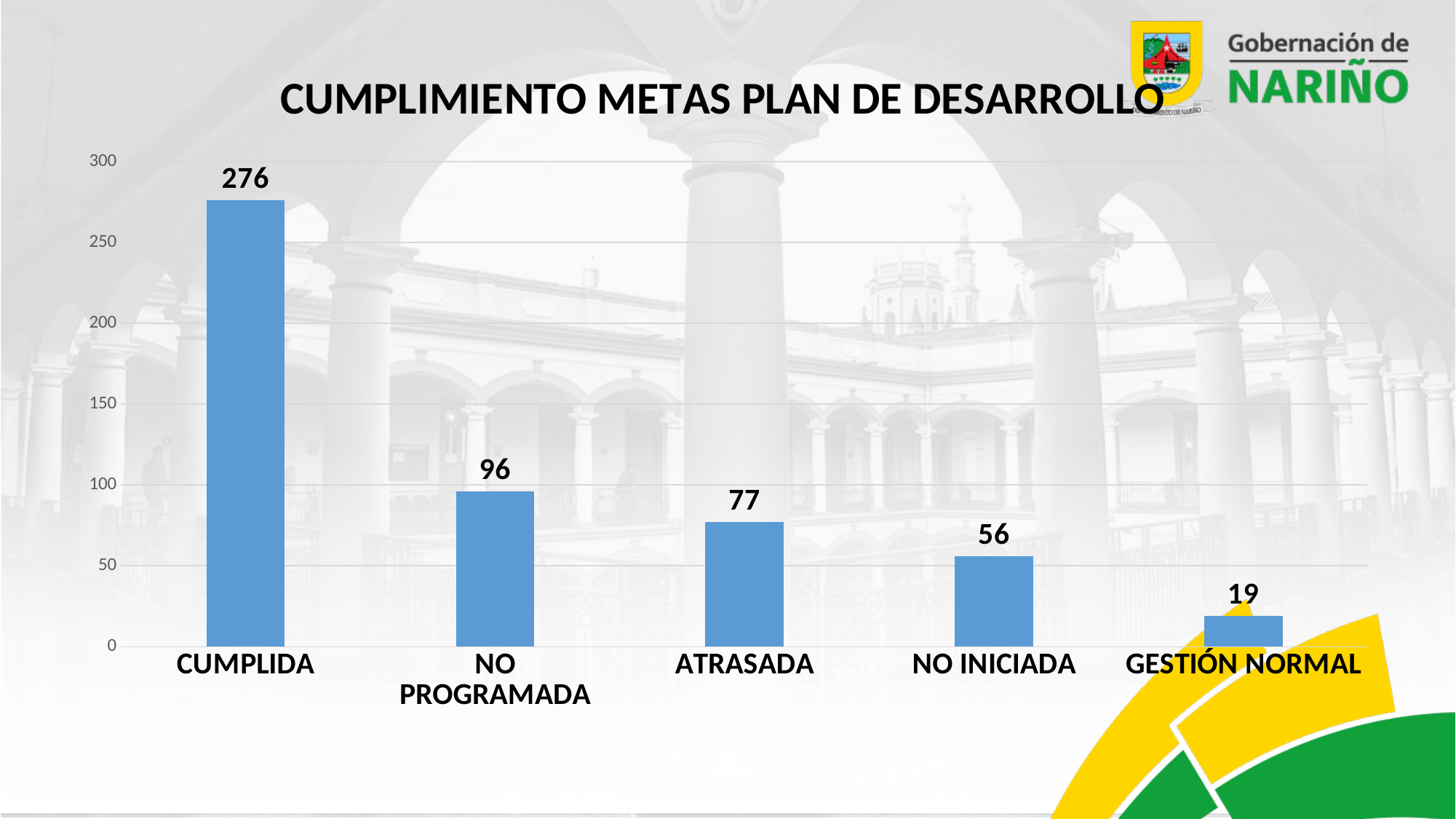
Which category has the highest value? CUMPLIDA What is the value for NO PROGRAMADA? 96 What is the value for ATRASADA? 77 How many categories are shown in the chart? 5 Which is larger, the value for ATRASADA or the value for NO INICIADA? ATRASADA What is the title of the chart? CUMPLIMIENTO METAS PLAN DE DESARROLLO Which category has the lowest value? GESTIÓN NORMAL What is the value for GESTIÓN NORMAL? 19 What is the difference between the values for CUMPLIDA and NO PROGRAMADA? 180 Is the value for NO INICIADA greater or less than 100? less What kind of chart is shown on the slide? bar chart What is the value for CUMPLIDA? 276